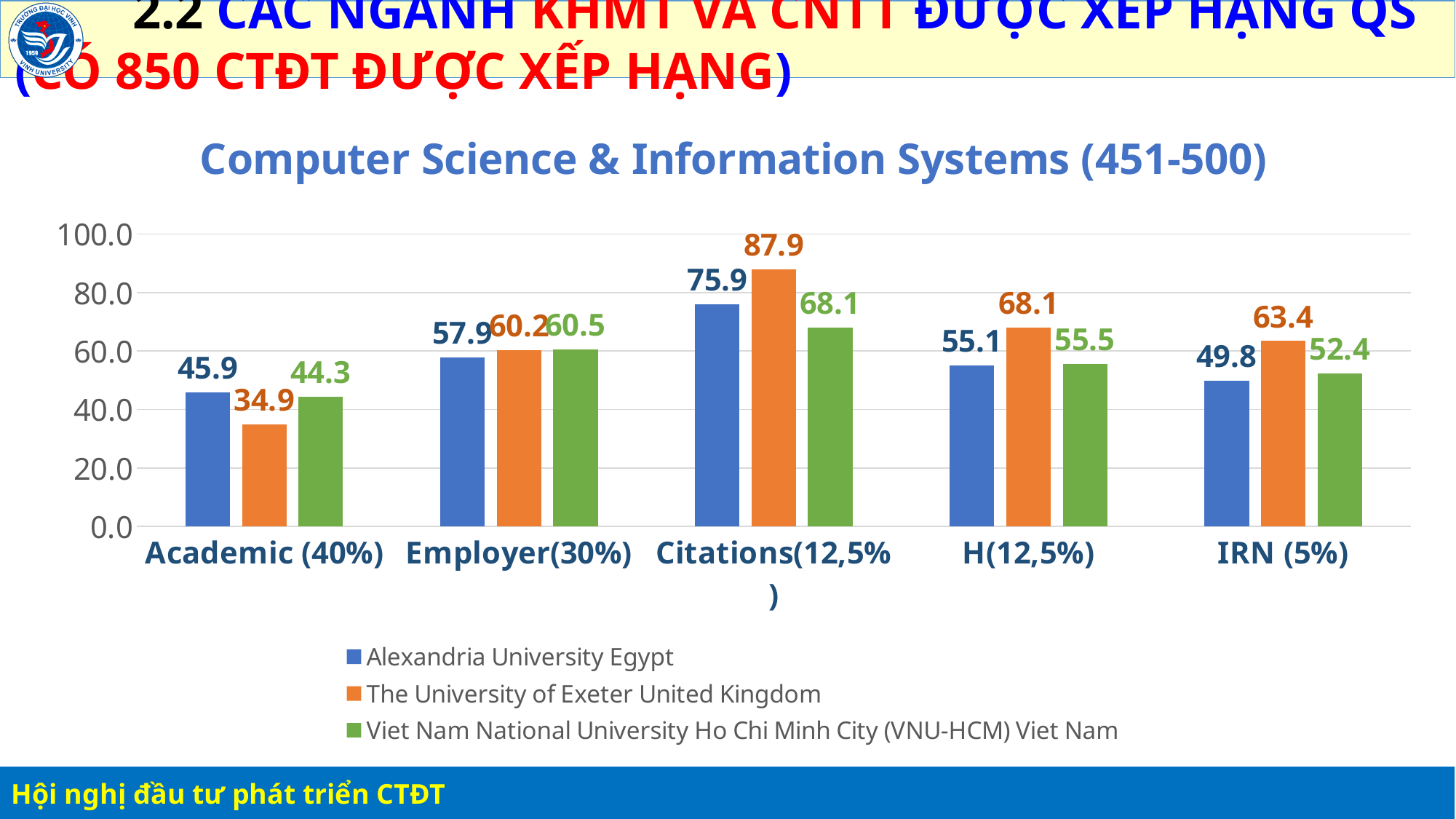
What kind of chart is shown on the slide? bar chart How many categories are shown on the x axis? 5 What is the difference between The University of Exeter United Kingdom and Alexandria University Egypt in the Citations(12,5%) category? 12.0 In which category does The University of Exeter United Kingdom have its highest value? Citations(12,5%) In which category does Alexandria University Egypt have its lowest value? Academic (40%) What is the title of the chart? Computer Science & Information Systems (451-500) What is the value for The University of Exeter United Kingdom in the Citations(12,5%) category? 87.9 Which is larger in the Academic (40%) category: Alexandria University Egypt or The University of Exeter United Kingdom? Alexandria University Egypt What is the value for Viet Nam National University Ho Chi Minh City (VNU-HCM) Viet Nam in the IRN (5%) category? 52.4 Is the value for The University of Exeter United Kingdom in the H(12,5%) category greater or less than 60.0? greater How many series does the legend list? 3 What is the value for Alexandria University Egypt in the Academic (40%) category? 45.9